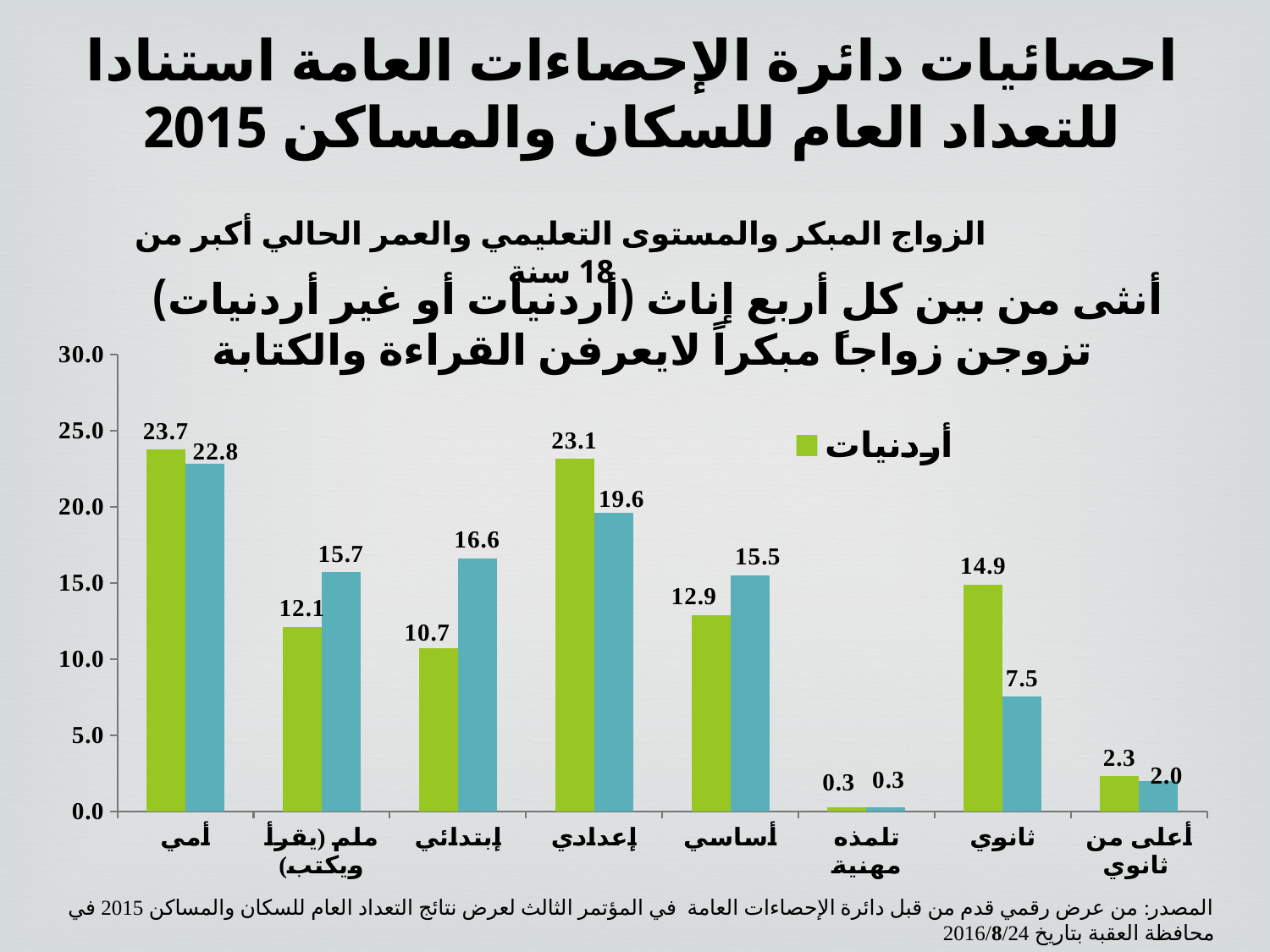
How many education-level categories are shown on the x axis? 8 What type of chart is shown on the slide? bar chart Which category has the lowest blue bar? تلمذه مهنية Is the blue bar for إعدادي greater or less than 20.0? less What is the value of the blue bar for إبتدائي? 16.6 What series name is shown in the chart legend? أردنيات For إعدادي, which bar is larger, the green (أردنيات) bar or the blue bar? green (أردنيات) What is the value of the green (أردنيات) bar for أمي? 23.7 Which category has the highest green (أردنيات) bar? أمي What is the difference between the green and blue bars for ثانوي? 7.4 What is the difference between the blue bar for ملم (يقرأ ويكتب) and the green bar for the same category? 3.6 What is the value of the green (أردنيات) bar for ثانوي? 14.9